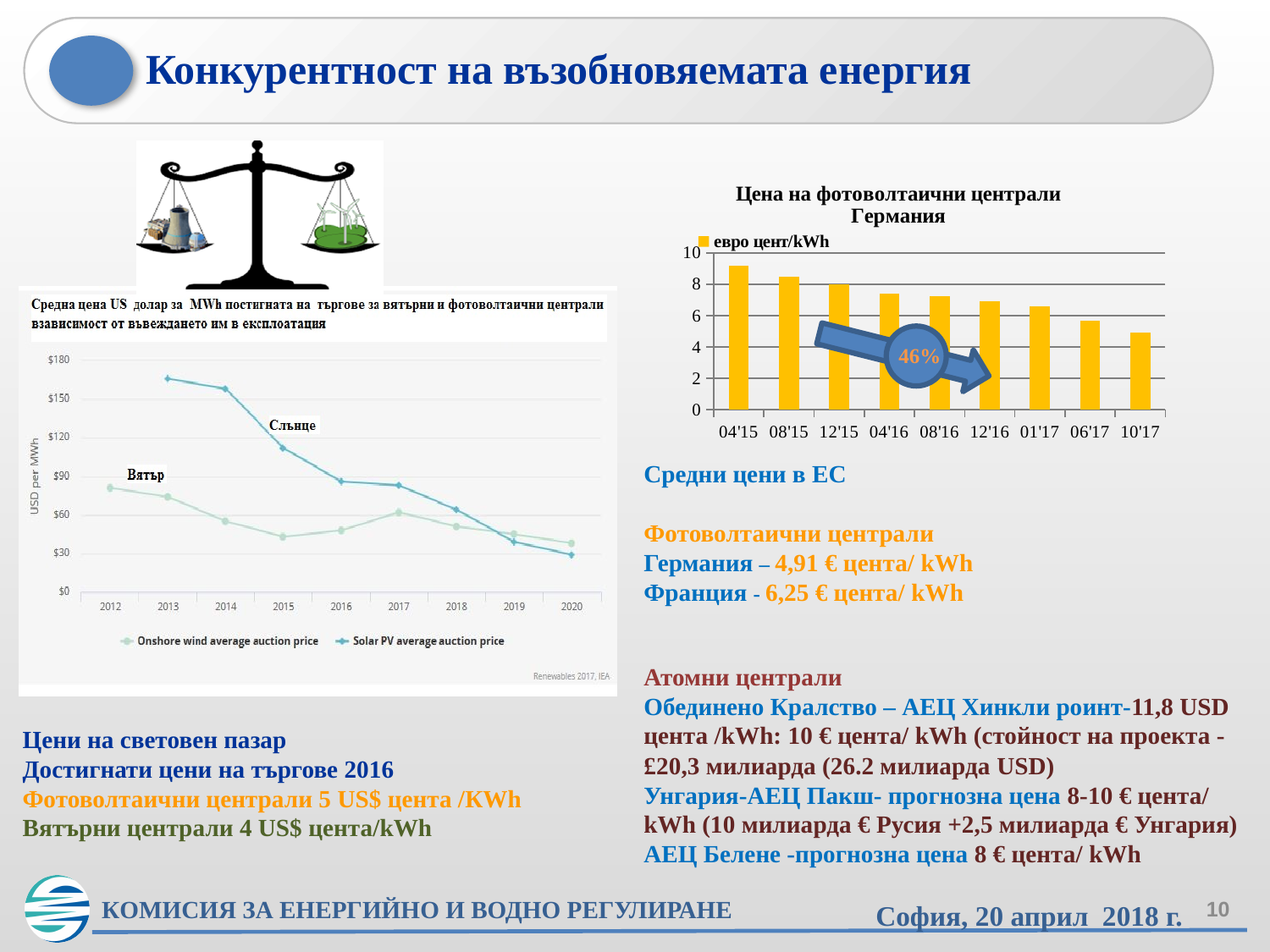
In the chart titled "Цена на фотоволтаични централи Германия", is the value for 04'15 greater or less than 8? greater In the chart titled "Цена на фотоволтаични централи Германия", which is larger: the value for 08'15 or the value for 06'17? 08'15 In the left chart (USD per MWh), in which year is the Solar PV average auction price highest? 2013 In the chart titled "Цена на фотоволтаични централи Германия", is the value for 10'17 greater or less than 6? less In the left chart (USD per MWh), is the Solar PV average auction price in 2015 greater or less than $90? greater How many bars are plotted in the chart titled "Цена на фотоволтаични централи Германия"? 9 How many series does the legend of the left chart (USD per MWh, 2012–2020) list? 2 In the chart titled "Цена на фотоволтаични централи Германия", do the values rise or fall from 04'15 to 10'17? fall In the chart titled "Цена на фотоволтаични централи Германия", which period has the highest value? 04'15 In the chart titled "Цена на фотоволтаични централи Германия", which period has the lowest value? 10'17 What kind of chart is the chart titled "Цена на фотоволтаични централи Германия"? bar chart What kind of chart is the chart on the left showing USD per MWh from 2012 to 2020? line chart